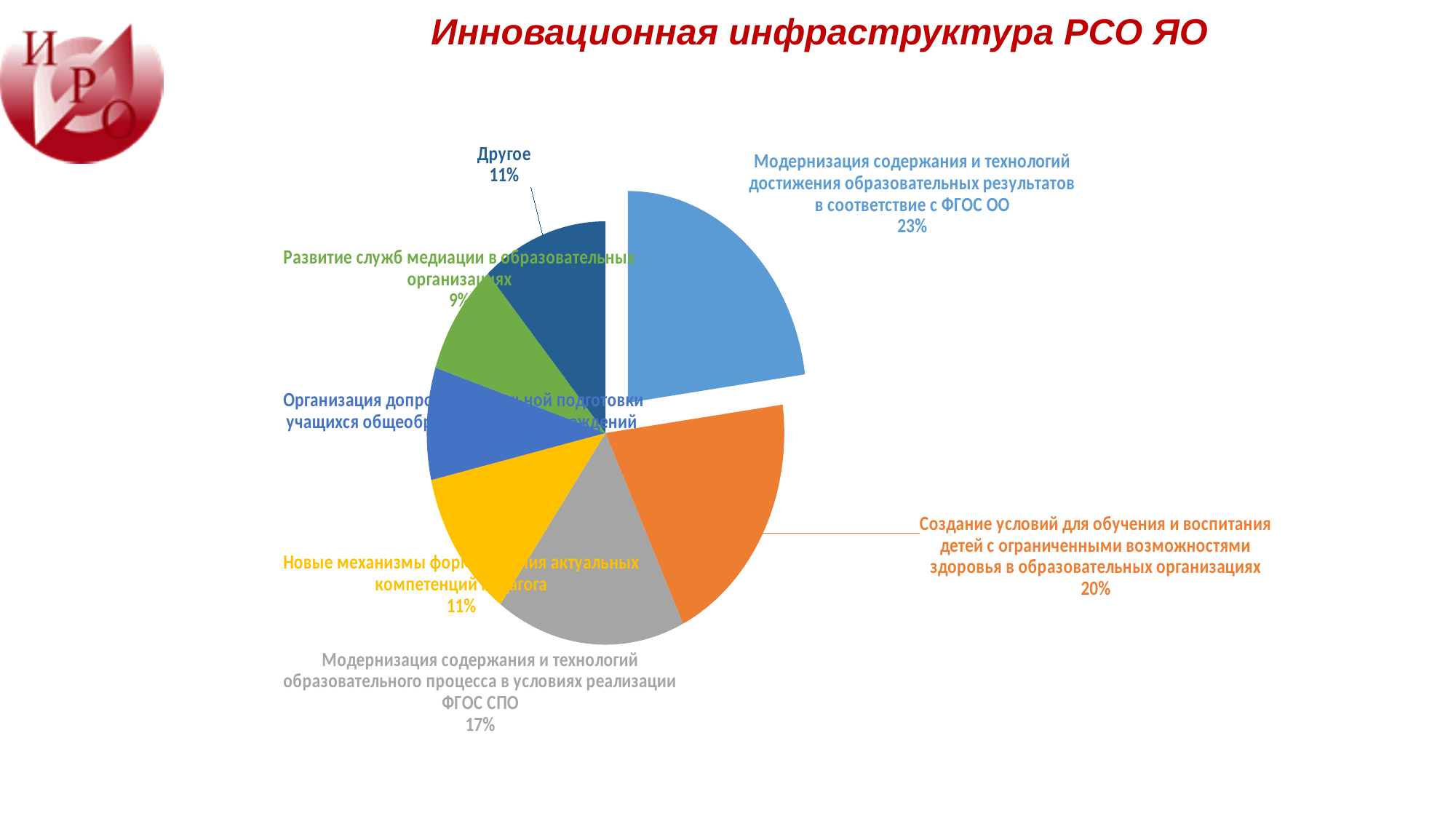
What colour is the slice for "Создание условий для обучения и воспитания детей с ограниченными возможностями здоровья в образовательных организациях"? orange Which category has the largest share of the pie? Модернизация содержания и технологий достижения образовательных результатов в соответствие с ФГОС ОО What is the difference in percentage points between the "ФГОС ОО" slice (23%) and the "ФГОС СПО" slice (17%)? 6 What share of the pie is labelled "Модернизация содержания и технологий достижения образовательных результатов в соответствие с ФГОС ОО"? 23% What percentage is shown for "Модернизация содержания и технологий образовательного процесса в условиях реализации ФГОС СПО"? 17% What percentage is shown for the slice labelled "Другое"? 11% Which is larger: the share for "Модернизация содержания и технологий достижения образовательных результатов в соответствие с ФГОС ОО" or the share for "Создание условий для обучения и воспитания детей с ограниченными возможностями здоровья в образовательных организациях"? Модернизация содержания и технологий достижения образовательных результатов в соответствие с ФГОС ОО What percentage is shown for "Развитие служб медиации в образовательных организациях"? 9% What percentage is shown for "Создание условий для обучения и воспитания детей с ограниченными возможностями здоровья в образовательных организациях"? 20% What is the title of the slide containing the chart? Инновационная инфраструктура РСО ЯО How many slices does the pie chart have? 7 What type of chart is shown on the slide? pie chart